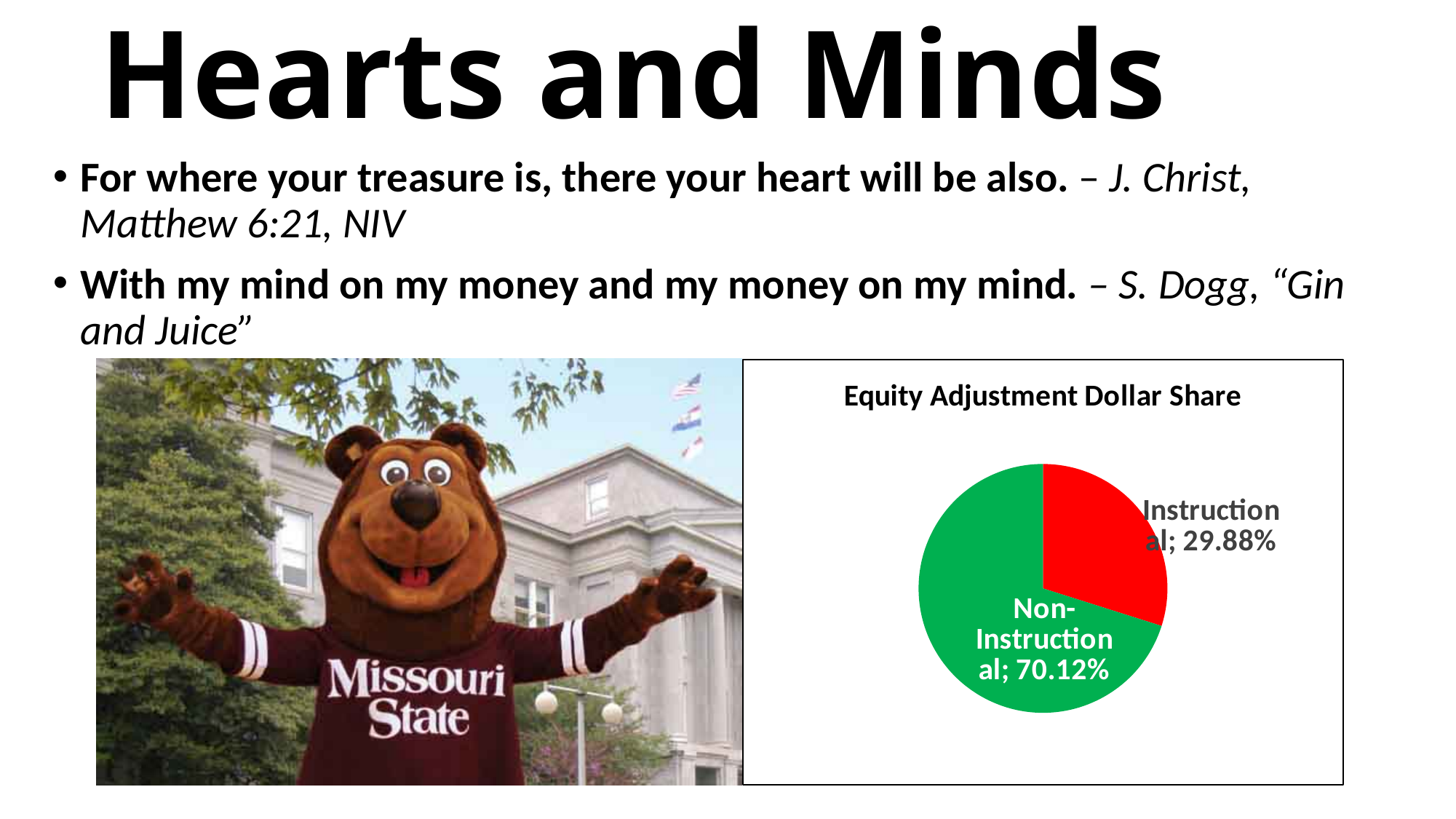
What share of the pie does the Non-Instructional slice represent? 70.12% How many slices does the pie chart have? 2 What is the title of the chart on the slide? Equity Adjustment Dollar Share Which slice of the pie is the largest? Non-Instructional Which slice of the pie is the smallest? Instructional What is the difference in percentage points between the Non-Instructional and Instructional shares? 40.24 Which is larger, the Instructional share or the Non-Instructional share? Non-Instructional What colour is the Non-Instructional slice of the pie? green What share of the pie does the Instructional slice represent? 29.88% What kind of chart is shown on the slide? pie chart